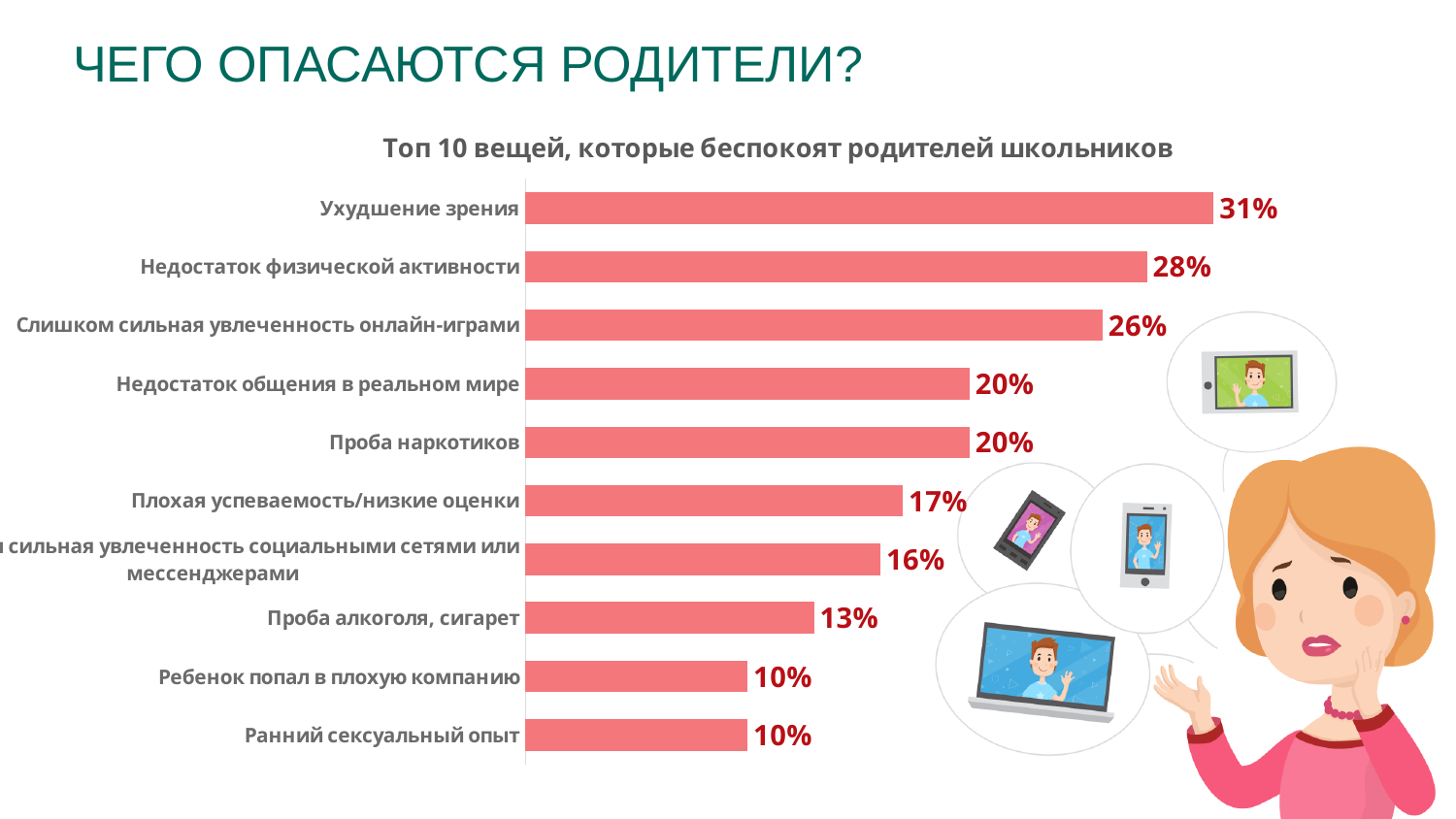
What is the difference between «Ухудшение зрения» and «Ранний сексуальный опыт»? 21% What is the value for «Плохая успеваемость/низкие оценки»? 17% What is the title of the chart? Топ 10 вещей, которые беспокоят родителей школьников What is the value for «Ребенок попал в плохую компанию»? 10% Which category has the highest value? Ухудшение зрения Which is larger: «Недостаток общения в реальном мире» or «Проба алкоголя, сигарет»? Недостаток общения в реальном мире What kind of chart is shown on the slide? Bar chart What is the value for «Проба алкоголя, сигарет»? 13% What is the value for «Ухудшение зрения»? 31% What is the difference between «Недостаток физической активности» and «Слишком сильная увлеченность онлайн-играми»? 2% How many categories are shown in the chart? 10 What is the value for «Проба наркотиков»? 20%